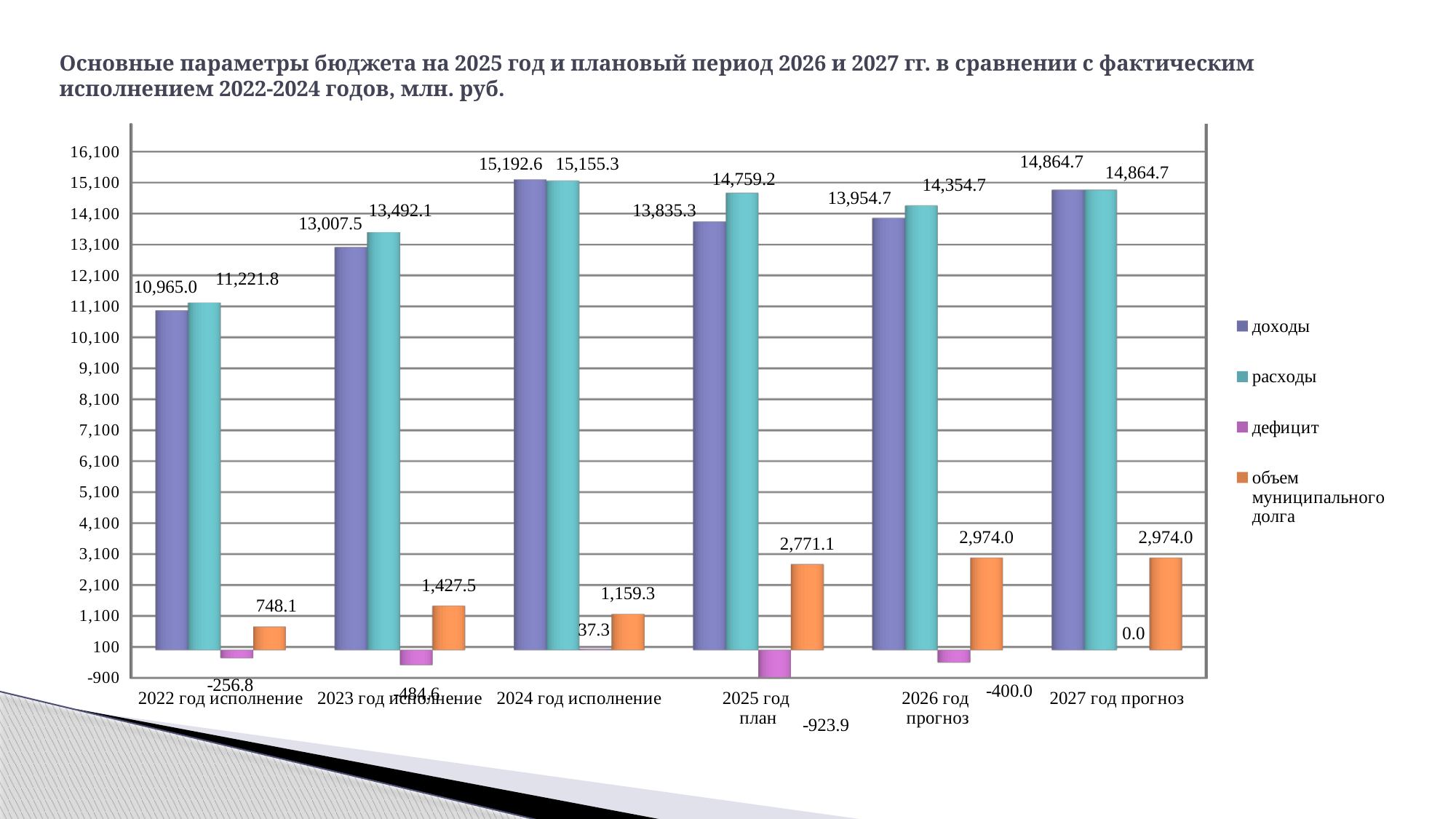
Which category has the highest value for доходы? 2024 год исполнение What kind of chart is shown on the slide? bar chart Which is larger for 2026 год прогноз: доходы or расходы? расходы What is the value of объем муниципального долга for 2023 год исполнение? 1,427.5 What is the value of дефицит for 2025 год план? -923.9 What is the value of доходы for 2024 год исполнение? 15,192.6 How many categories are shown on the x axis? 6 What is the value of расходы for 2025 год план? 14,759.2 What is the difference between расходы and доходы for 2022 год исполнение? 256.8 Does the value of объем муниципального долга rise or fall from 2024 год исполнение to 2026 год прогноз? rise How many series does the legend list? 4 Which category has the lowest value for объем муниципального долга? 2022 год исполнение